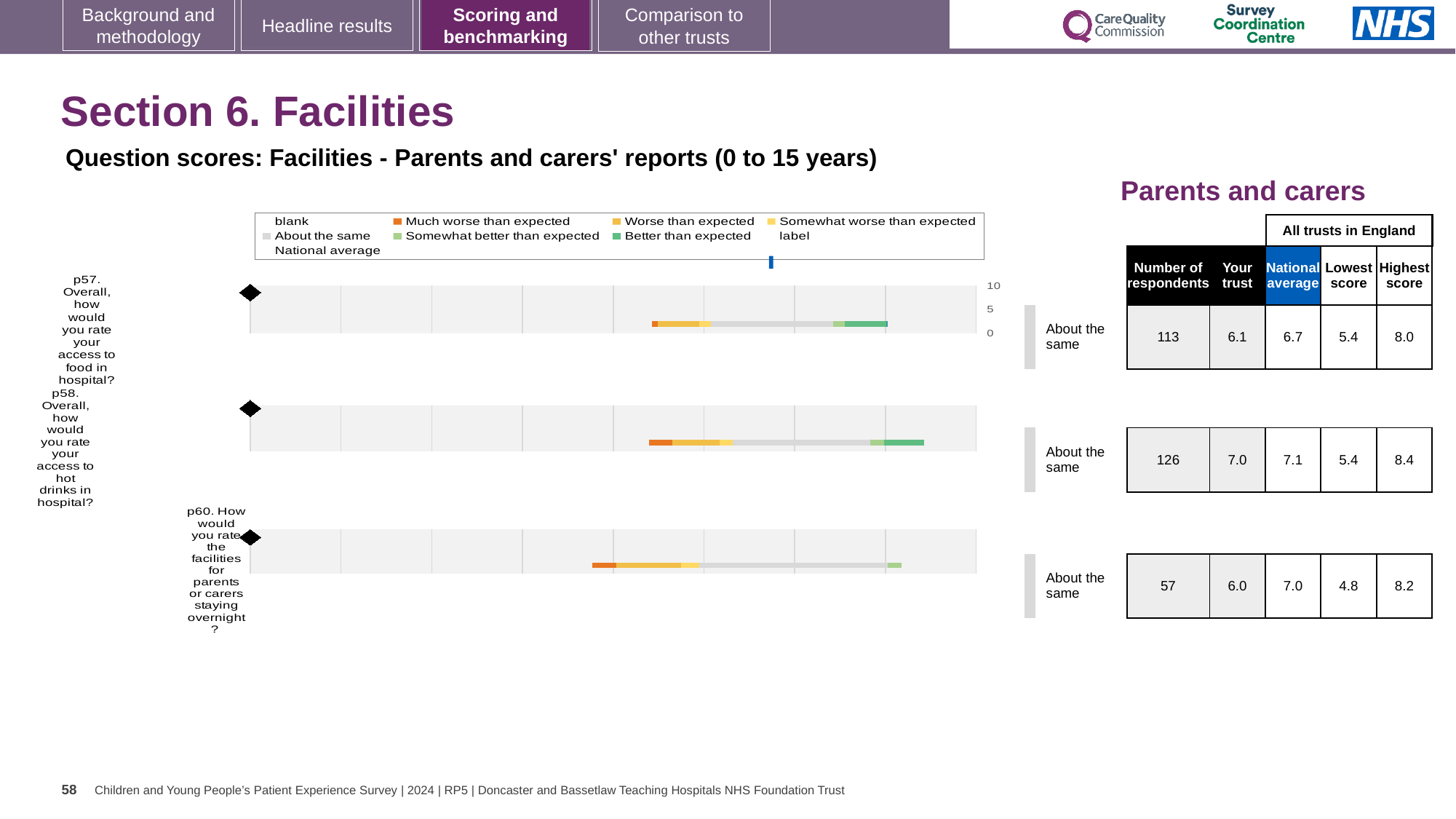
What is the highest score among all trusts in England for p58? 8.4 How many respondents answered p60 (facilities for parents or carers staying overnight)? 57 Which question has the highest 'Your trust' score? p58 By how much does the national average exceed the 'Your trust' score for p57? 0.6 What is the 'Your trust' score for p57 (access to food in hospital)? 6.1 What is the national average score for p58 (access to hot drinks in hospital)? 7.1 What benchmark category is shown for all three questions on this slide? About the same How many questions are plotted in the Facilities chart? 3 For p60, which is larger: the 'Your trust' score or the national average? National average Which question has the lowest 'Lowest score' across all trusts in England? p60 What is the difference between the highest score and the lowest score for p57? 2.6 What kind of chart is used to show the question scores on this slide? Bar chart